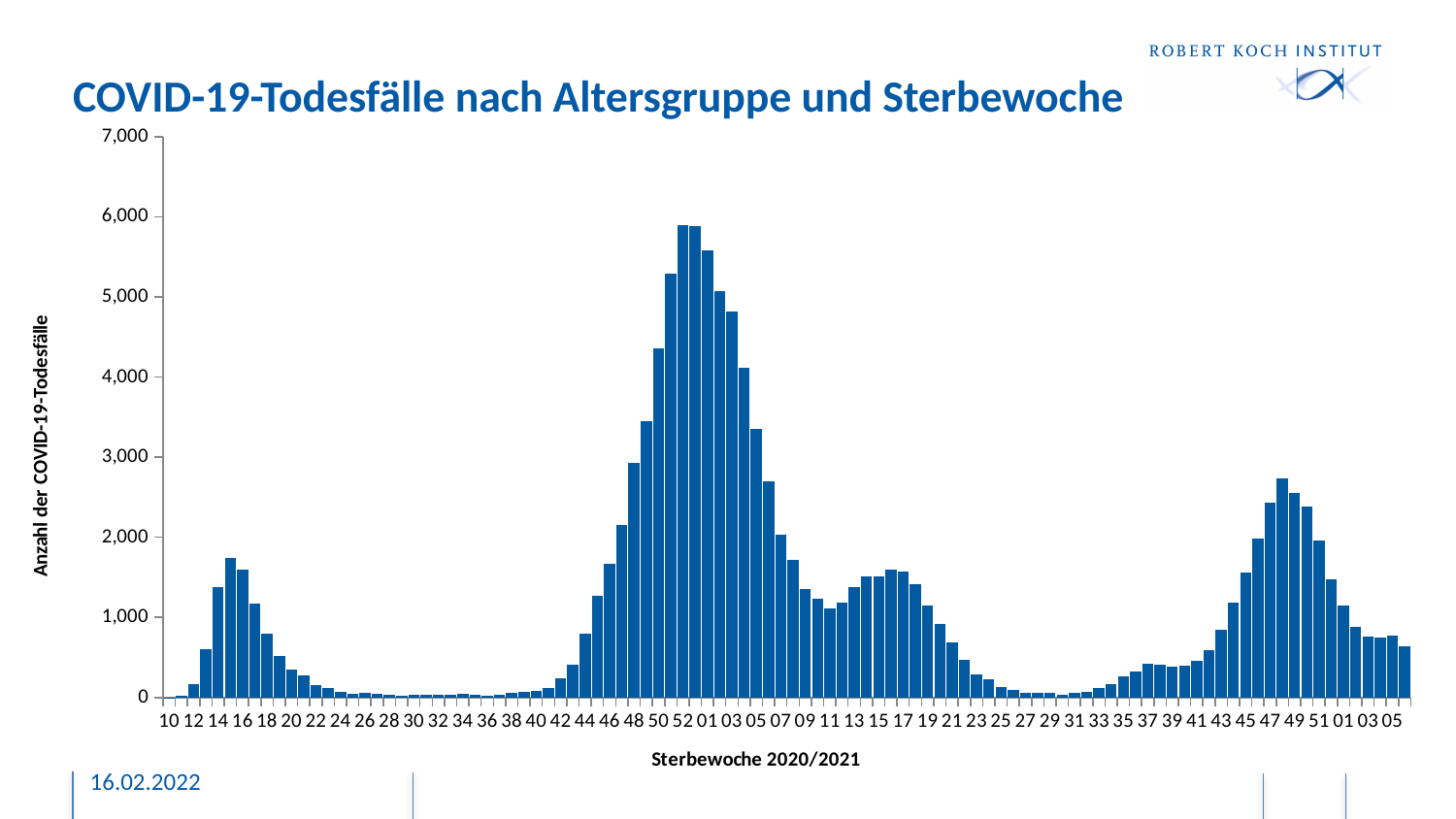
Is the value for Sterbewoche 28 (2021) greater or less than 1,000? less Do the values rise or fall from Sterbewoche 01 (2021) to Sterbewoche 11 (2021)? fall Is the value for Sterbewoche 01 (2021) greater or less than 5,000? greater What kind of chart is shown on the slide? bar chart Is the value for Sterbewoche 15 (2020) greater or less than 1,000? greater Which is larger, the value for Sterbewoche 52 (2020) or the value for Sterbewoche 48 (2021)? Sterbewoche 52 (2020) Do the values rise or fall from Sterbewoche 40 (2020) to Sterbewoche 50 (2020)? rise What is the title of the chart? COVID-19-Todesfälle nach Altersgruppe und Sterbewoche What is the label of the vertical axis? Anzahl der COVID-19-Todesfälle